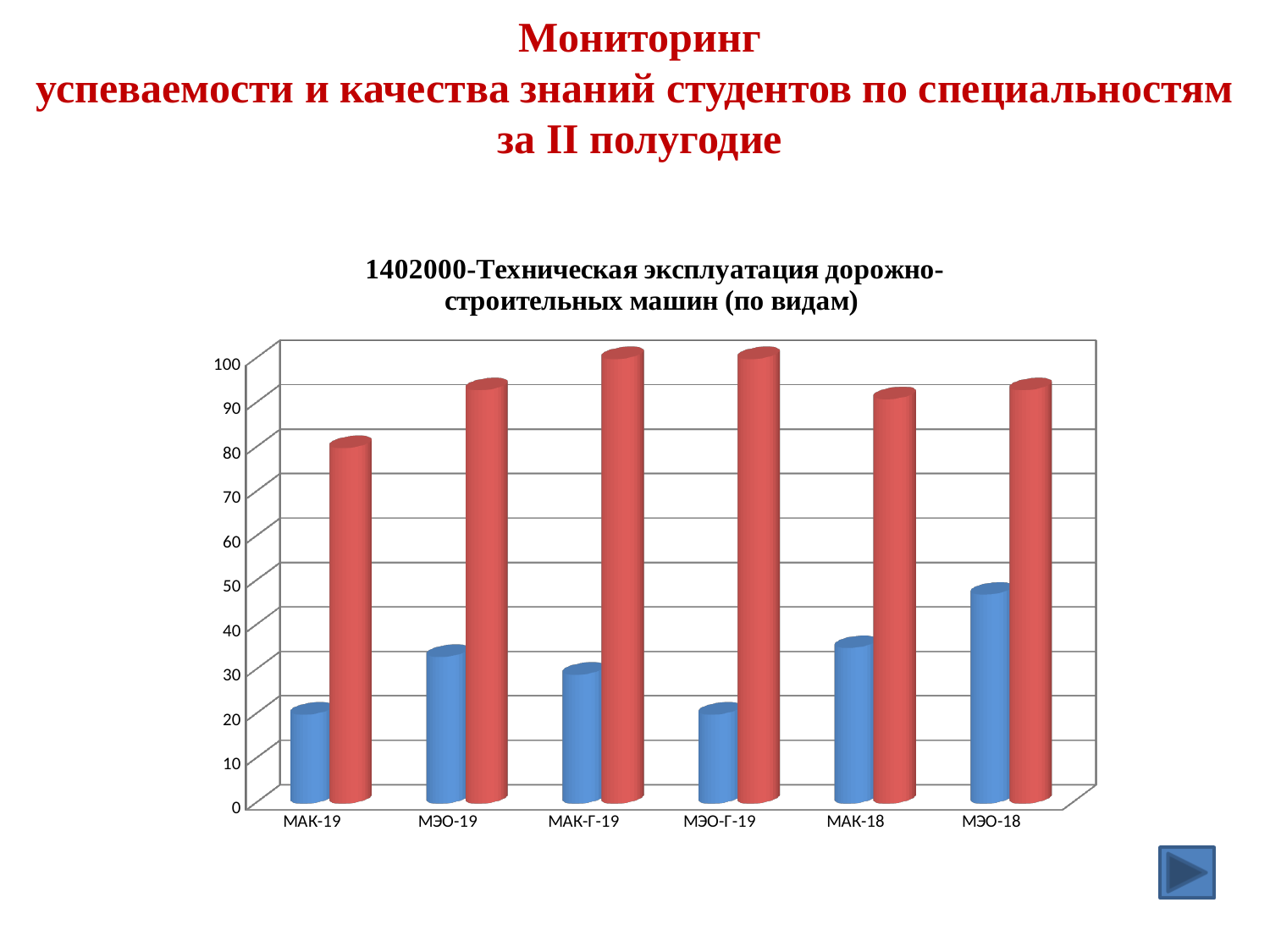
For МЭО-Г-19, which bar is taller, the red one or the blue one? the red one Is the value of the blue bar for МАК-19 greater or less than 30? less What kind of chart is shown on the slide? bar chart Is the value of the red bar for МАК-19 greater or less than 90? less Is the value of the red bar for МЭО-19 greater or less than 80? greater Which category has the tallest blue bar? МЭО-18 Which category has the shortest red bar? МАК-19 What is the title of the chart? 1402000-Техническая эксплуатация дорожно-строительных машин (по видам) Which is larger: the blue bar for МАК-18 or the blue bar for МАК-19? МАК-18 How many categories are shown on the x axis of the chart? 6